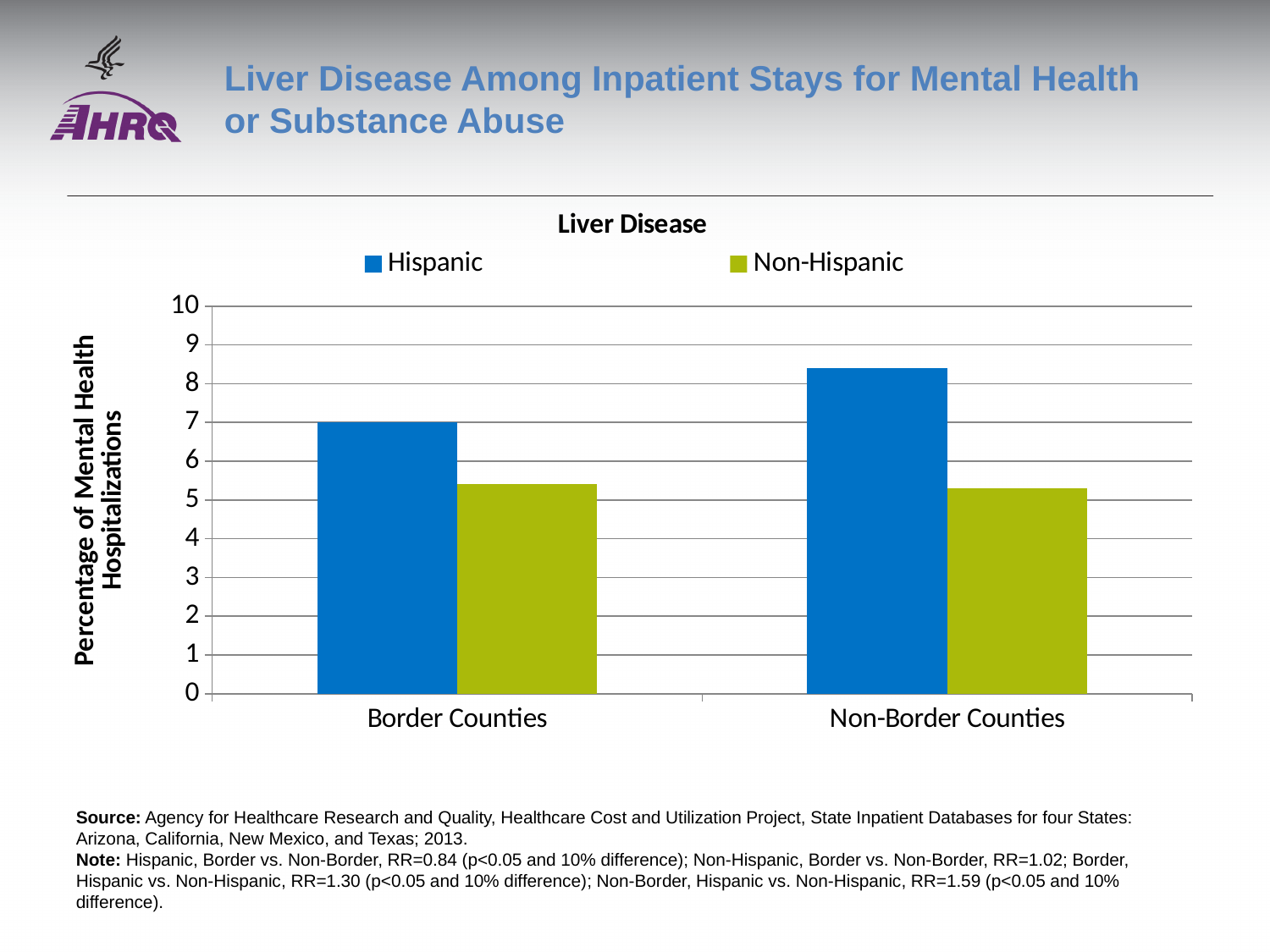
Which series and category has the highest bar? Hispanic, Non-Border Counties What is the label of the y axis? Percentage of Mental Health Hospitalizations Is the Hispanic value for Non-Border Counties greater or less than 8? greater In Border Counties, which is larger: the Hispanic value or the Non-Hispanic value? Hispanic For the Hispanic series, which is larger: Border Counties or Non-Border Counties? Non-Border Counties In Non-Border Counties, which is larger: the Hispanic value or the Non-Hispanic value? Hispanic How many categories are shown on the x axis? 2 Is the Non-Hispanic value for Border Counties greater or less than 6? less How many series does the legend list? 2 What is the title of the chart? Liver Disease What kind of chart is shown on the slide? Bar chart Is the Non-Hispanic value for Non-Border Counties greater or less than 5? greater